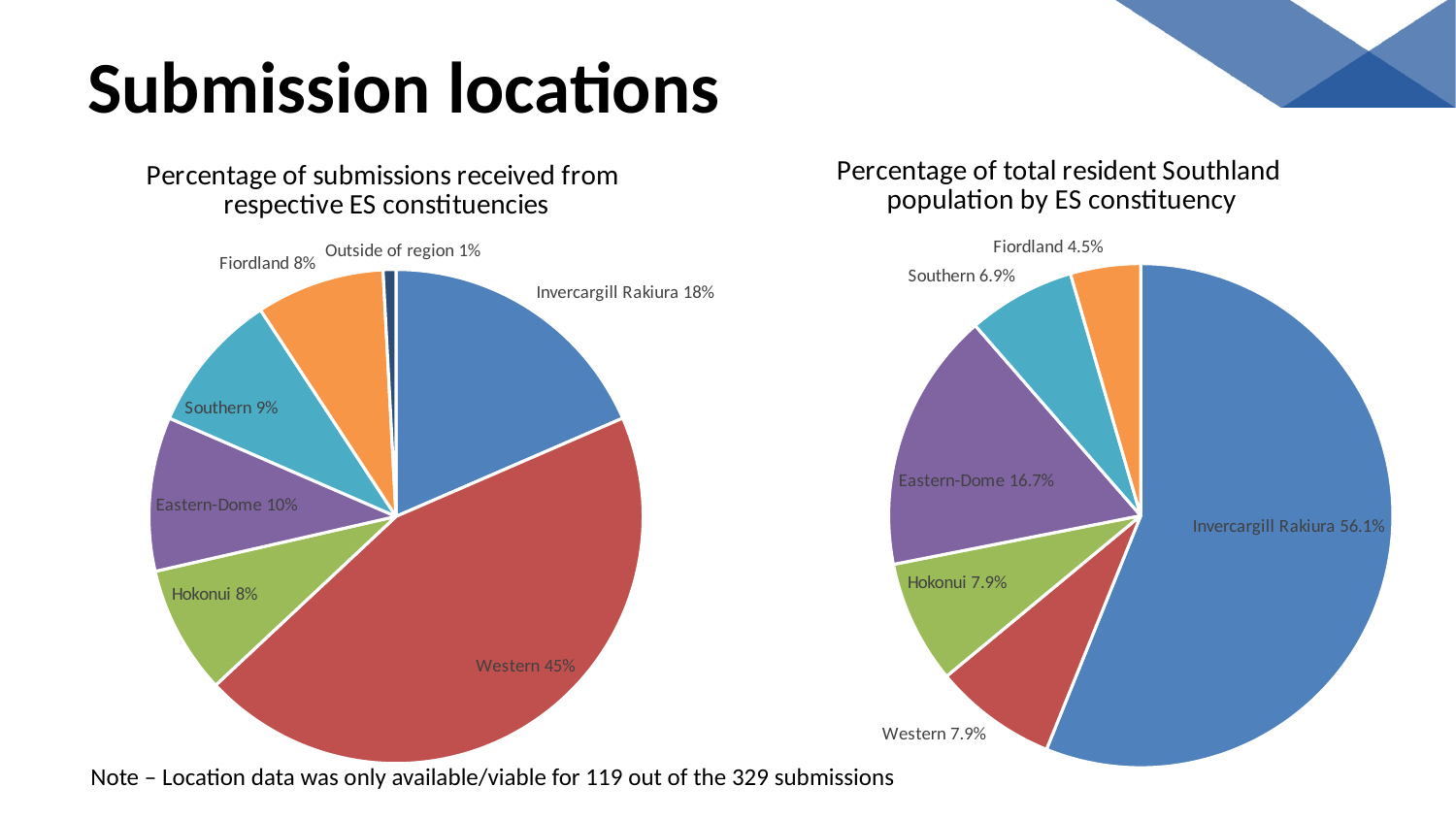
In the right chart, what is the difference between the Eastern-Dome share and the Southern share? 9.8% In the right chart, which category has the largest share? Invercargill Rakiura How many categories are shown in the left chart? 7 What type of chart is used on this slide? Pie chart In the left chart, which is larger: Eastern-Dome or Southern? Eastern-Dome In the left chart, which category has the smallest share? Outside of region In the left chart, which category has the largest share? Western How many categories are shown in the right chart? 6 In the right chart, which category has the smallest share? Fiordland In the chart titled 'Percentage of total resident Southland population by ES constituency', what is the value for Invercargill Rakiura? 56.1% In the chart titled 'Percentage of submissions received from respective ES constituencies', what is the value for Western? 45% In the left chart, what is the difference between the Western share and the Invercargill Rakiura share? 27%